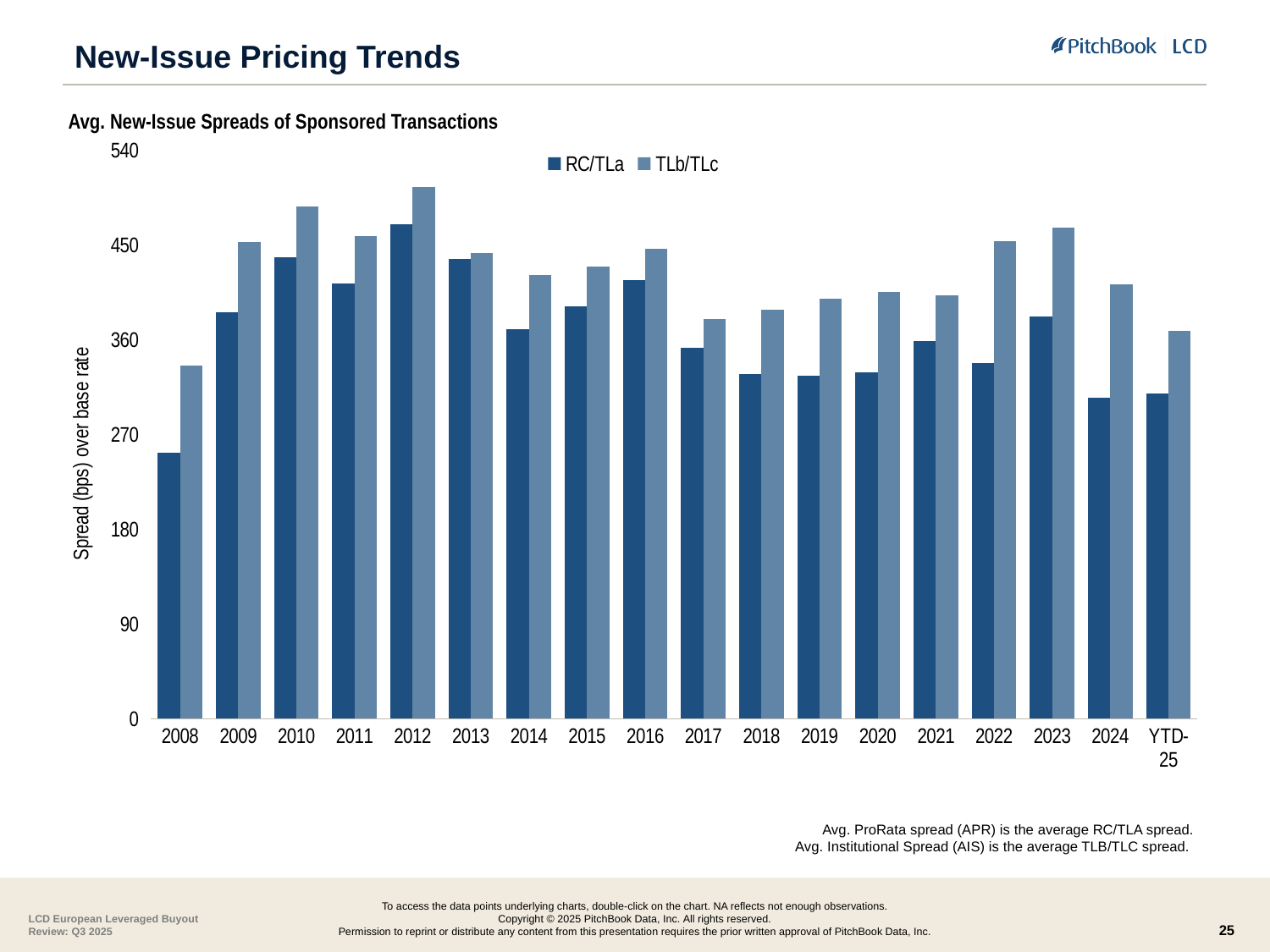
How many year categories are shown on the x axis? 18 How many series does the legend list? 2 In which year is the RC/TLa spread lowest? 2008 Is the RC/TLa value for 2008 greater or less than 270? less In which year is the RC/TLa spread highest? 2012 Is the TLb/TLc value for 2012 greater or less than 450? greater Which is larger, the TLb/TLc spread in 2010 or in 2017? 2010 Does the RC/TLa spread rise or fall from 2012 to 2019? Fall Is the RC/TLa value for 2024 greater or less than 360? less In which year is the TLb/TLc spread highest? 2012 What kind of chart is shown on the slide? Bar chart What is the label on the y axis? Spread (bps) over base rate